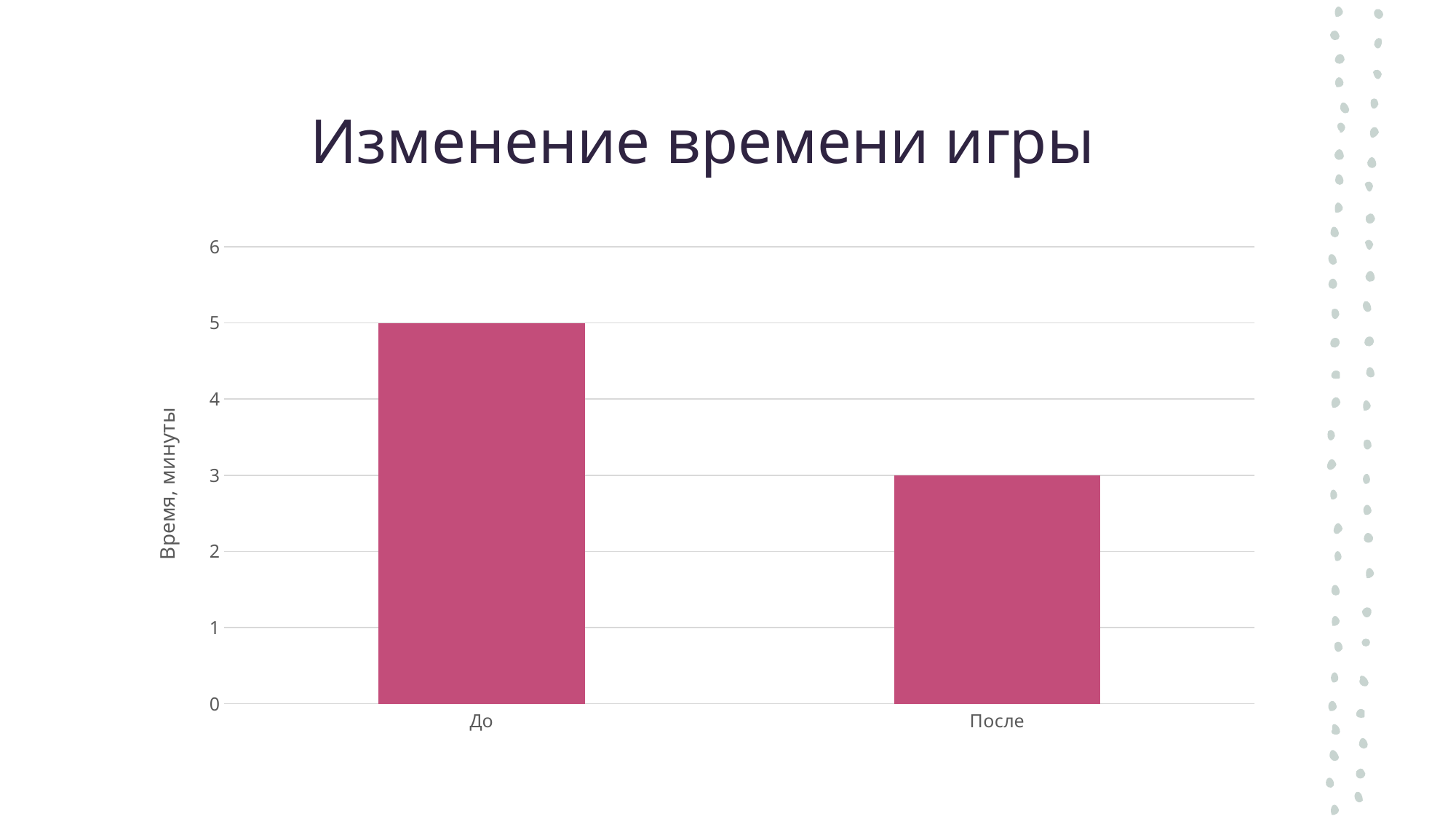
What is the value for До? 5 What is the title of the chart? Изменение времени игры How many categories are shown on the x axis? 2 What kind of chart is shown on the slide? bar chart Which category has the lowest value? После Do the values rise or fall from До to После? fall Is the value for До greater or less than 4? greater What is the value for После? 3 Is the value for После greater or less than 4? less Which is larger, the value for До or the value for После? До What is the difference between the values for До and После? 2 Which category has the highest value? До